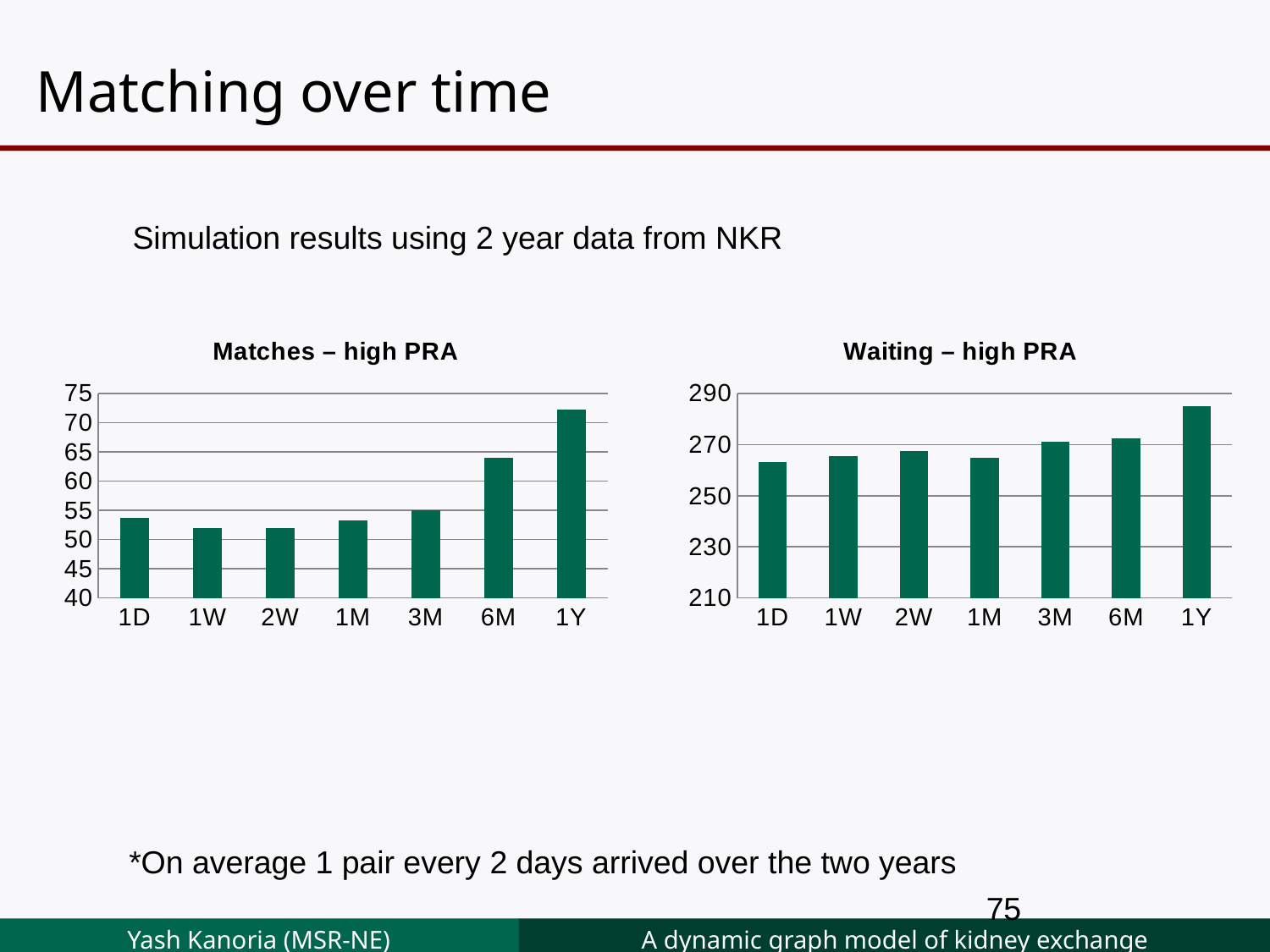
In the "Waiting – high PRA" chart, is the value for 1D greater or less than 270? less In the "Waiting – high PRA" chart, which category has the highest value? 1Y In the "Matches – high PRA" chart, which category has the highest value? 1Y In the "Matches – high PRA" chart, is the value for 1Y greater or less than 70? greater In the "Matches – high PRA" chart, which is larger, the value for 6M or the value for 3M? 6M How many categories are shown on the x axis of the "Waiting – high PRA" chart? 7 In the "Matches – high PRA" chart, is the value for 1W greater or less than 55? less What kind of chart is the "Matches – high PRA" chart? bar chart In the "Waiting – high PRA" chart, which is larger, the value for 1Y or the value for 1D? 1Y What is the title of the chart on the right side of the slide? Waiting – high PRA